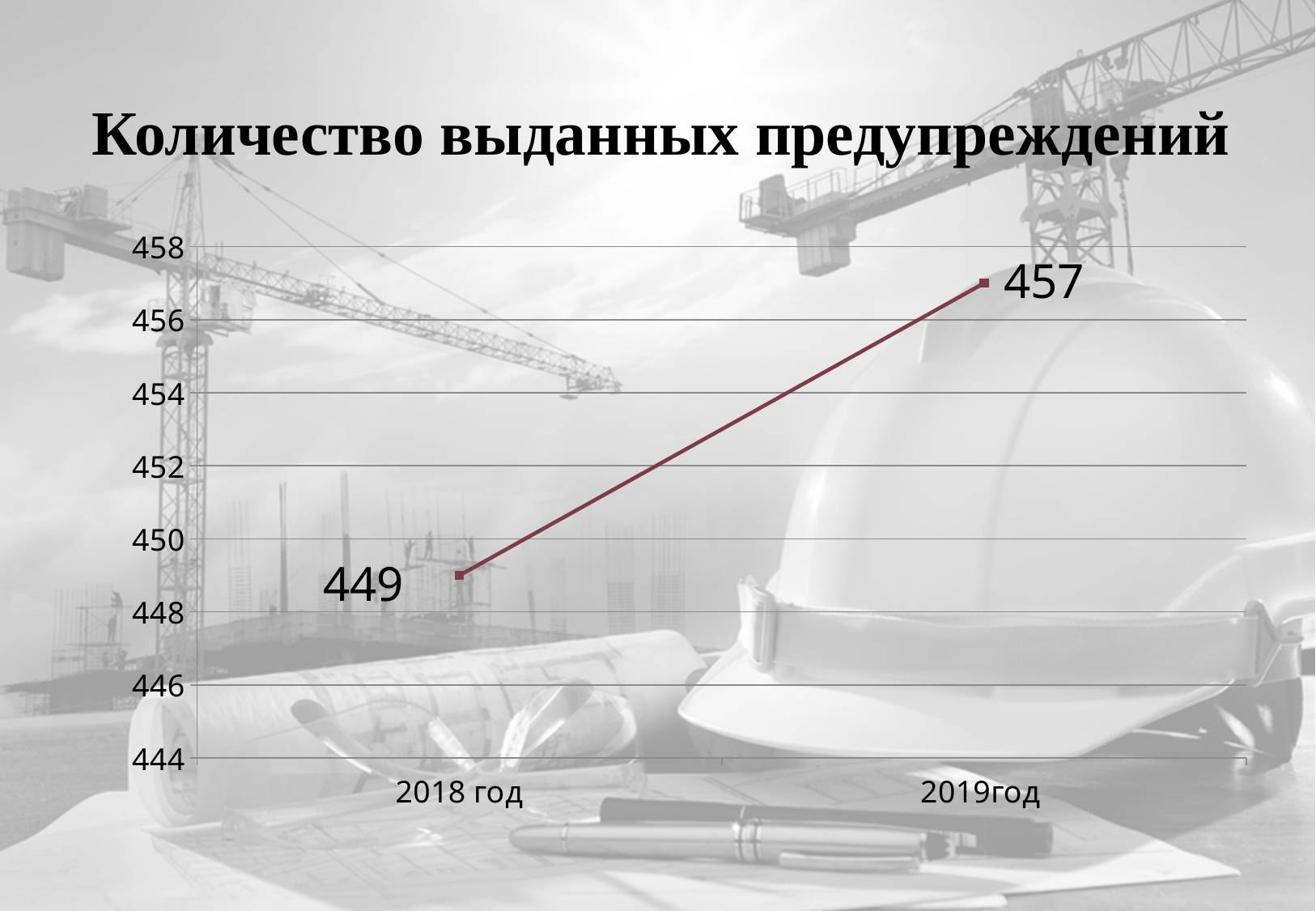
What is the difference between the values for 2019год and 2018 год? 8 Is the value for 2019год greater or less than 456? greater What is the value for 2018 год? 449 Which year has the highest value? 2019год Which year has the lowest value? 2018 год What kind of chart is shown on the slide? line chart Do the values rise or fall from 2018 год to 2019год? rise What is the value for 2019год? 457 Is the value for 2018 год greater or less than 450? less Which is larger, the value for 2018 год or the value for 2019год? 2019год What is the title of the chart? Количество выданных предупреждений How many data points are plotted on the chart? 2